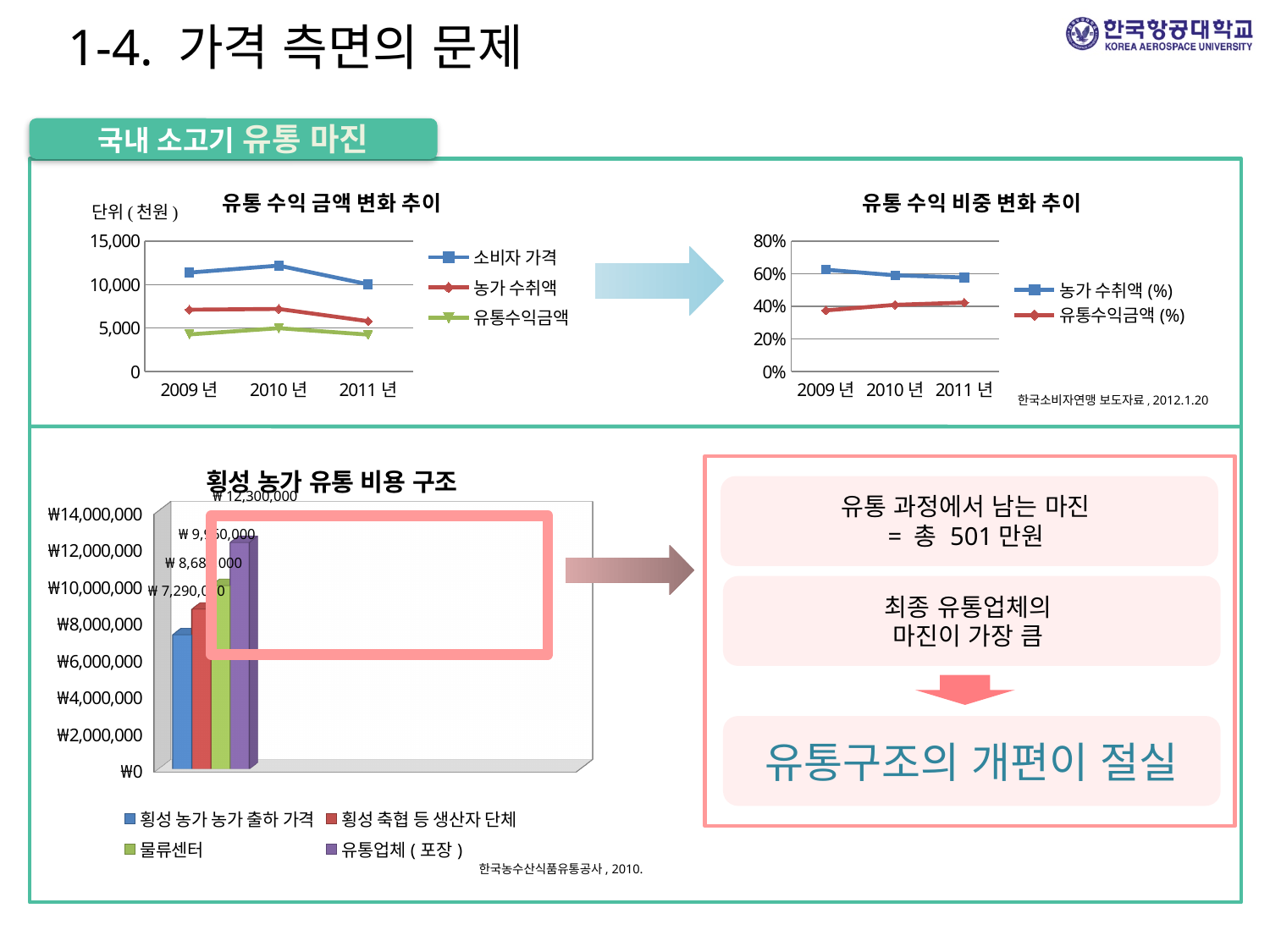
In the chart titled 유통 수익 비중 변화 추이, does the 농가 수취액 (%) line rise or fall from 2009 년 to 2011 년? fall In the chart titled 유통 수익 금액 변화 추이, is the value for 소비자 가격 in 2010 년 greater or less than 10,000? greater In the chart titled 횡성 농가 유통 비용 구조, which series has the lowest value? 횡성 농가 농가 출하 가격 In the chart titled 횡성 농가 유통 비용 구조, how many series does the legend list? 4 In the chart titled 유통 수익 금액 변화 추이, which series has the highest values across all years? 소비자 가격 In the chart titled 횡성 농가 유통 비용 구조, which series has the highest value? 유통업체 ( 포장 ) In the chart titled 유통 수익 금액 변화 추이, how many series does the legend list? 3 What kind of chart is 횡성 농가 유통 비용 구조? bar chart In the chart titled 유통 수익 비중 변화 추이, does the 유통수익금액 (%) line rise or fall from 2009 년 to 2011 년? rise In the chart titled 유통 수익 금액 변화 추이, is the value for 농가 수취액 in 2009 년 greater or less than 5,000? greater In the chart titled 유통 수익 비중 변화 추이, how many series does the legend list? 2 In the chart titled 유통 수익 비중 변화 추이, is the value for 농가 수취액 (%) in 2009 년 greater or less than 40%? greater